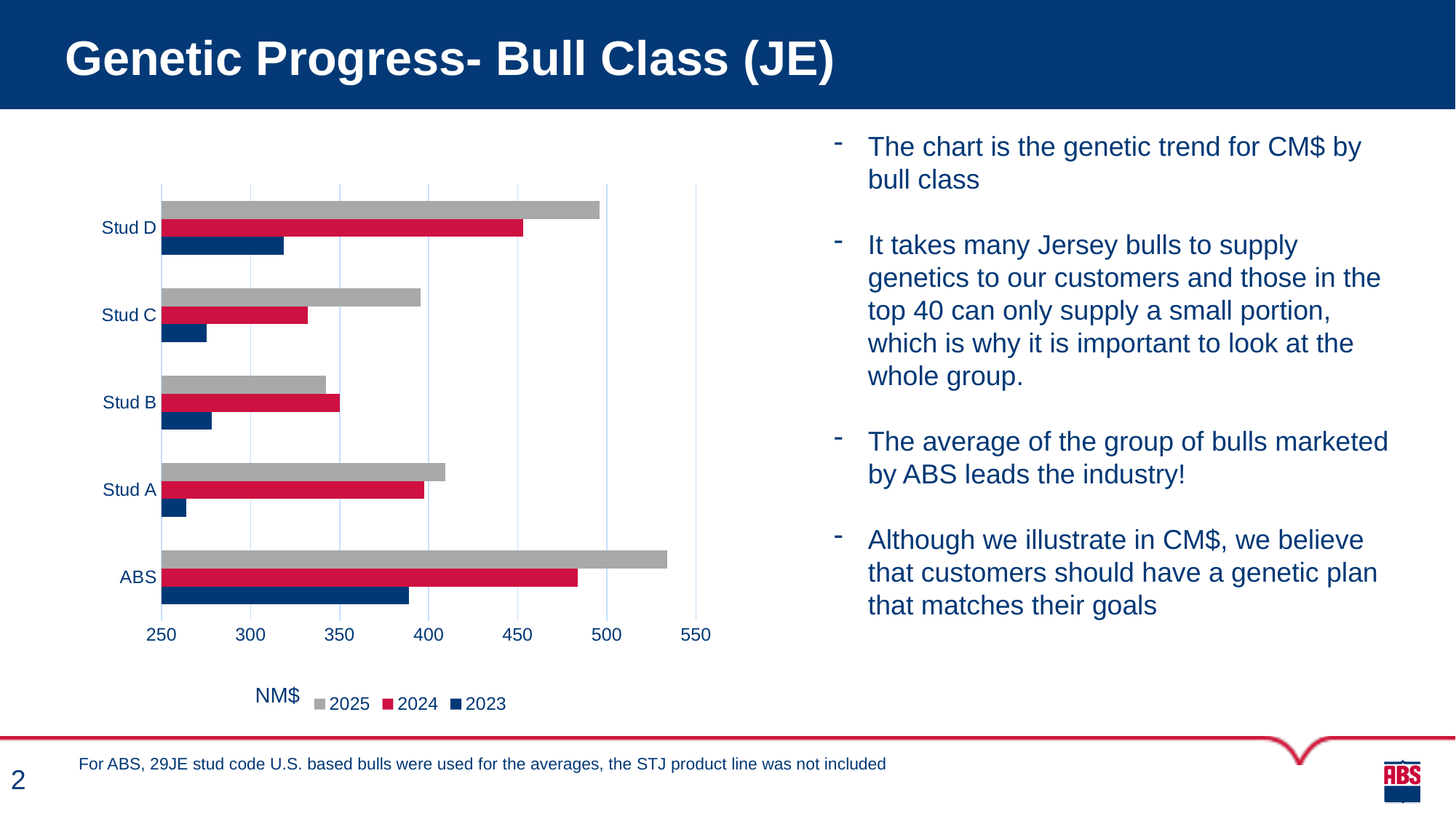
Is the 2025 value for ABS greater or less than 500? greater Which category has the lowest 2023 value? Stud A Is the 2023 value for Stud A greater or less than 300? less Is the 2023 value for Stud D greater or less than 300? greater Which category has the highest 2025 value? ABS How many series does the chart legend list? 3 What label is shown on the horizontal axis of the chart? NM$ Which is larger, the 2025 value for ABS or the 2025 value for Stud D? ABS What kind of chart is shown on the slide? bar chart Which is larger, the 2024 value for Stud D or the 2024 value for Stud A? Stud D How many categories are shown on the chart? 5